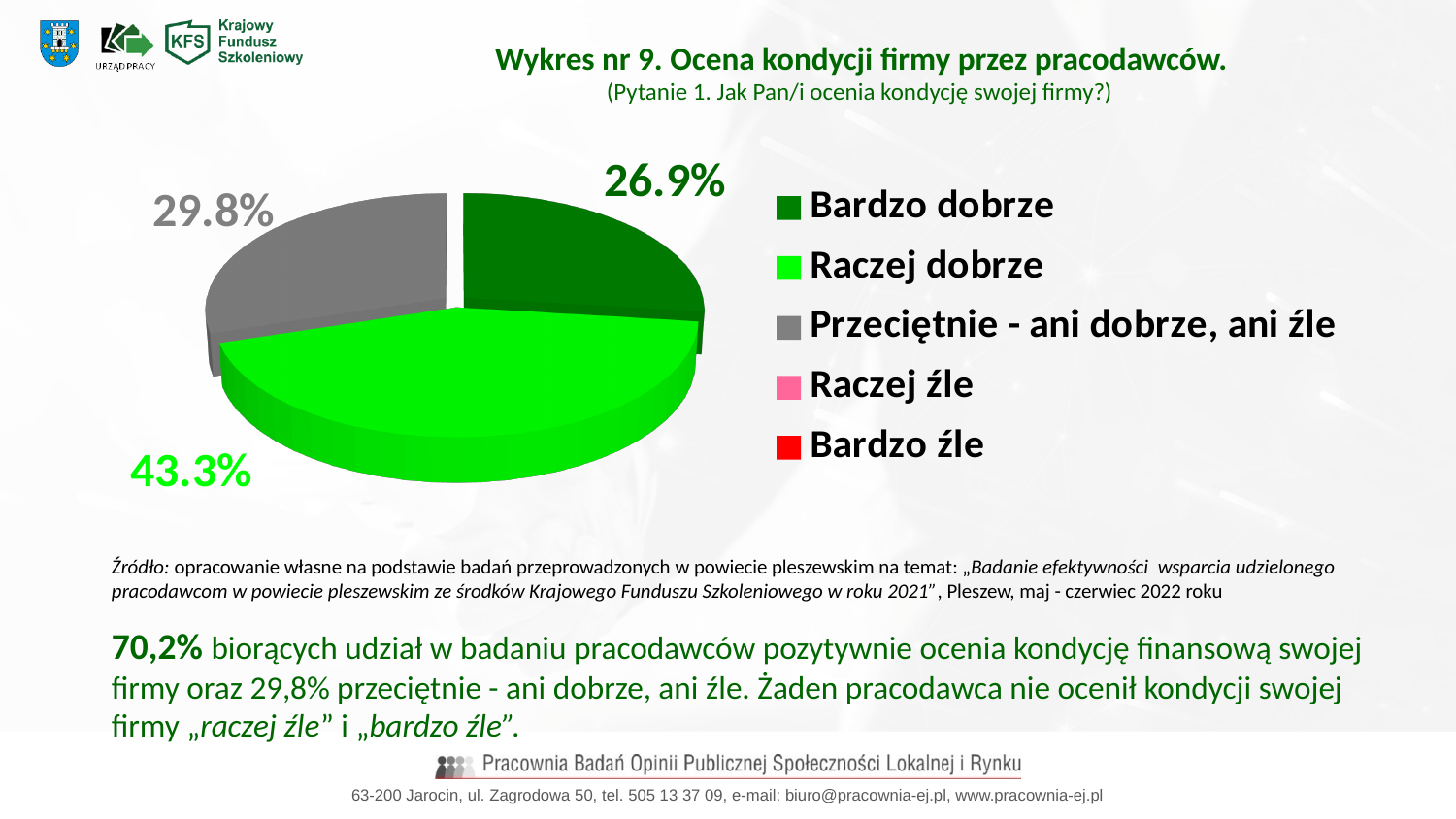
What share of employers rated their company's condition as "Bardzo dobrze"? 26.9% What is the difference between the shares for "Przeciętnie - ani dobrze, ani źle" and "Bardzo dobrze"? 2.9% What share of employers rated their company's condition as "Przeciętnie - ani dobrze, ani źle"? 29.8% Among the slices shown with values, which category has the smallest share? Bardzo dobrze What is the difference between the shares for "Raczej dobrze" and "Bardzo dobrze"? 16.4% Which category has the largest slice of the pie? Raczej dobrze How many slices with data labels are visible in the pie chart? 3 What share of employers rated their company's condition as "Raczej dobrze"? 43.3% Which is larger: the share for "Przeciętnie - ani dobrze, ani źle" or the share for "Bardzo dobrze"? Przeciętnie - ani dobrze, ani źle What type of chart is shown on the slide? pie chart What colour is the slice for "Przeciętnie - ani dobrze, ani źle"? gray How many entries does the legend list? 5